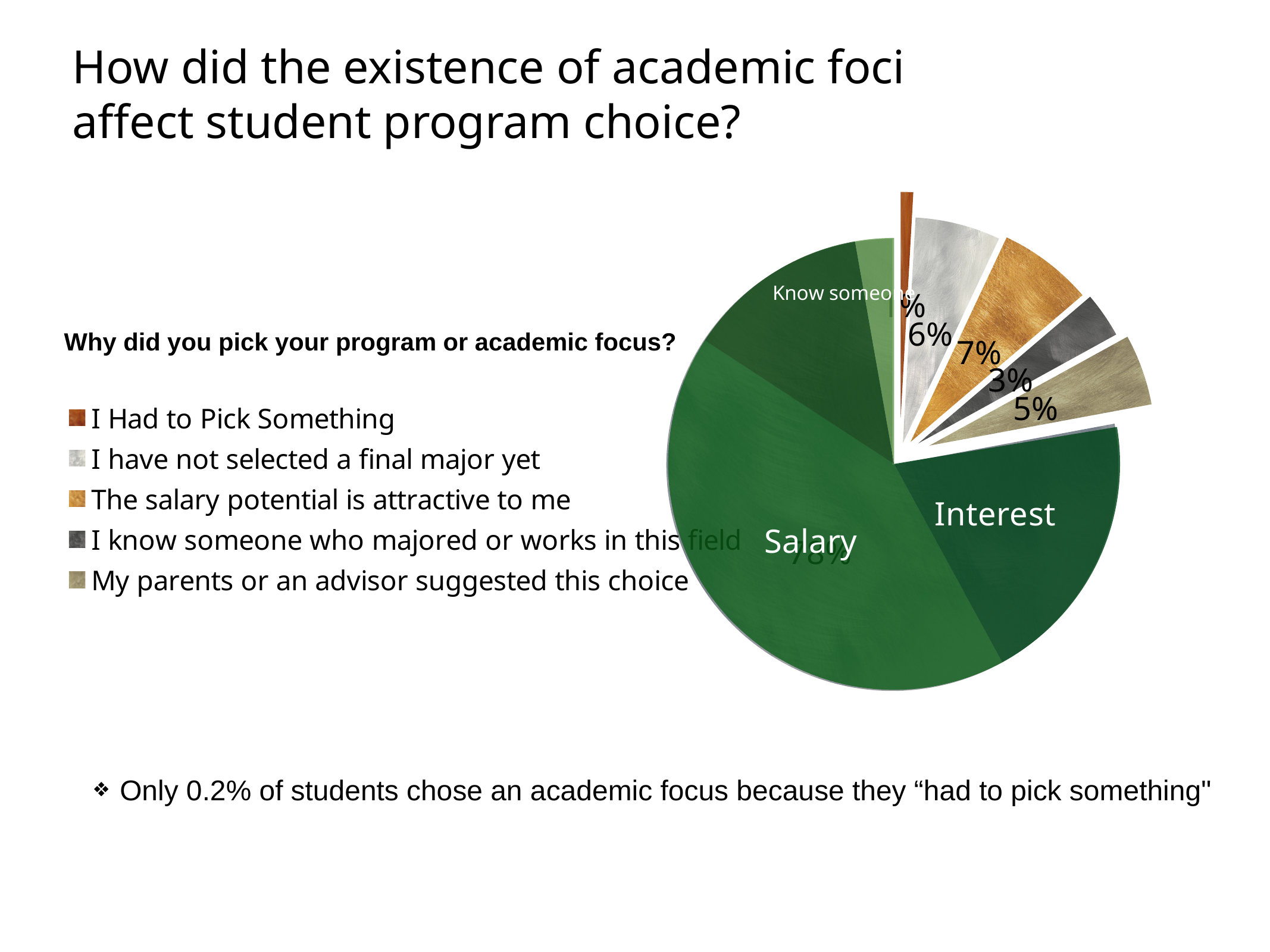
What percentage is shown for the 'I Had to Pick Something' slice? 1% What percentage of students picked their program because they know someone who majored or works in the field? 3% How many entries does the legend of the pie chart list? 5 What percentage of students chose their program because the salary potential is attractive to them? 7% What colour is the legend marker for 'I have not selected a final major yet'? Light grey Which is larger: the share for 'The salary potential is attractive to me' or 'My parents or an advisor suggested this choice'? The salary potential is attractive to me What percentage of students said their parents or an advisor suggested the choice? 5% What is the difference in percentage points between 'The salary potential is attractive to me' and 'I know someone who majored or works in this field'? 4 percentage points Which legend category has the smallest slice in the pie chart? I Had to Pick Something What question is printed above the legend of the pie chart? Why did you pick your program or academic focus? What percentage of students have not selected a final major yet? 6% What kind of chart is shown on the slide? Pie chart